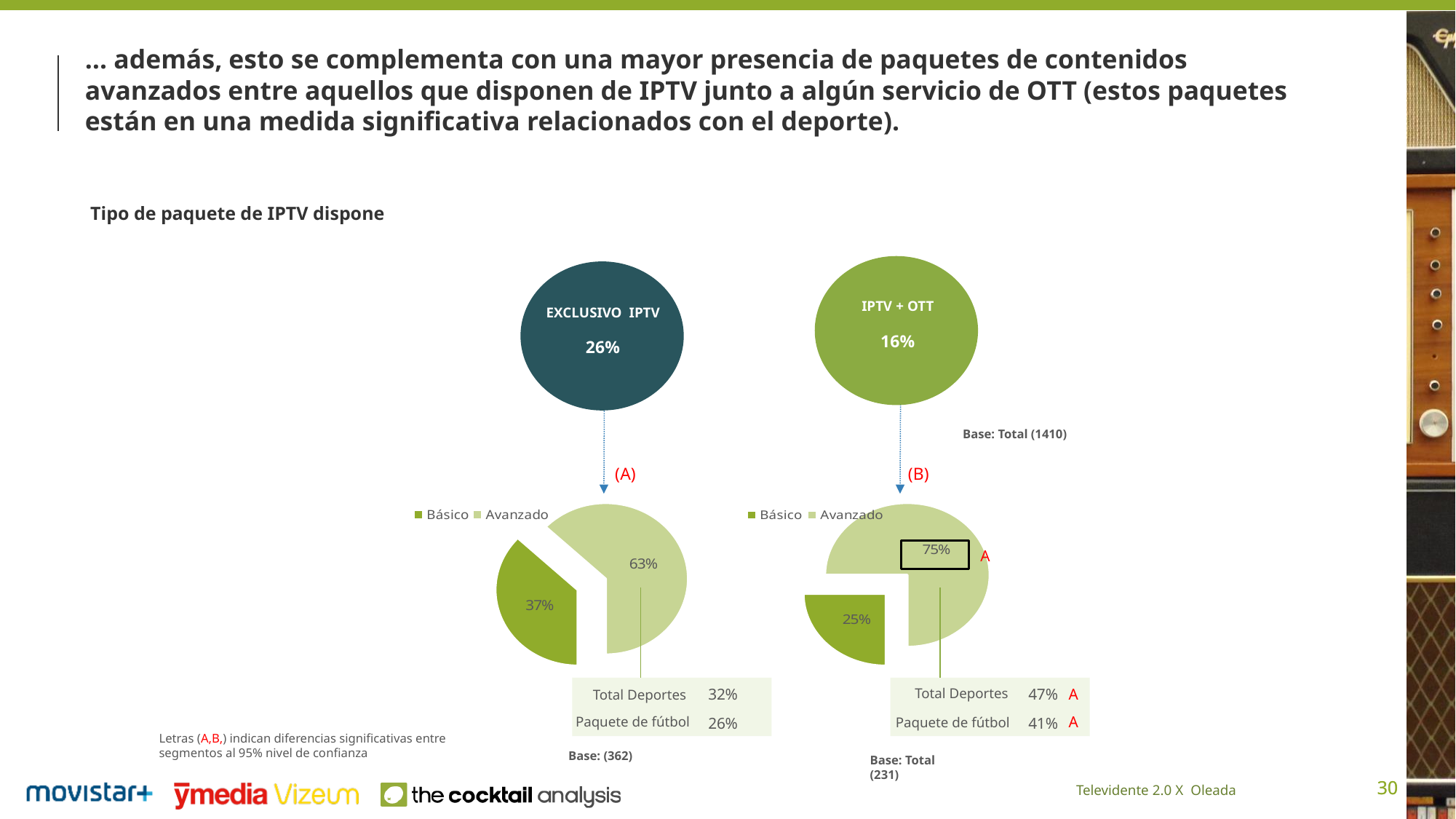
In the left pie chart (A, Exclusivo IPTV), what is the difference between the Avanzado and Básico slices? 26 percentage points How many slices does the right pie chart (B, IPTV + OTT) have? 2 How many entries does the legend of the left pie chart (A) list? 2 In the right pie chart (B, IPTV + OTT), which slice is the largest? Avanzado In the left pie chart (A, Exclusivo IPTV), which slice is the smallest? Básico Which is larger: the Avanzado slice in the left pie chart (A) or the Avanzado slice in the right pie chart (B)? Right pie chart (B) In the left pie chart (A, Exclusivo IPTV), what is the value for Básico? 37% In the right pie chart (B, IPTV + OTT), what is the value for Avanzado? 75% What are the two legend entries shown above the right pie chart (B)? Básico and Avanzado In the right pie chart (B, IPTV + OTT), what is the value for Básico? 25% What type of chart is used to show the Básico and Avanzado split for each segment? Pie chart In the left pie chart (A, Exclusivo IPTV), what is the value for Avanzado? 63%